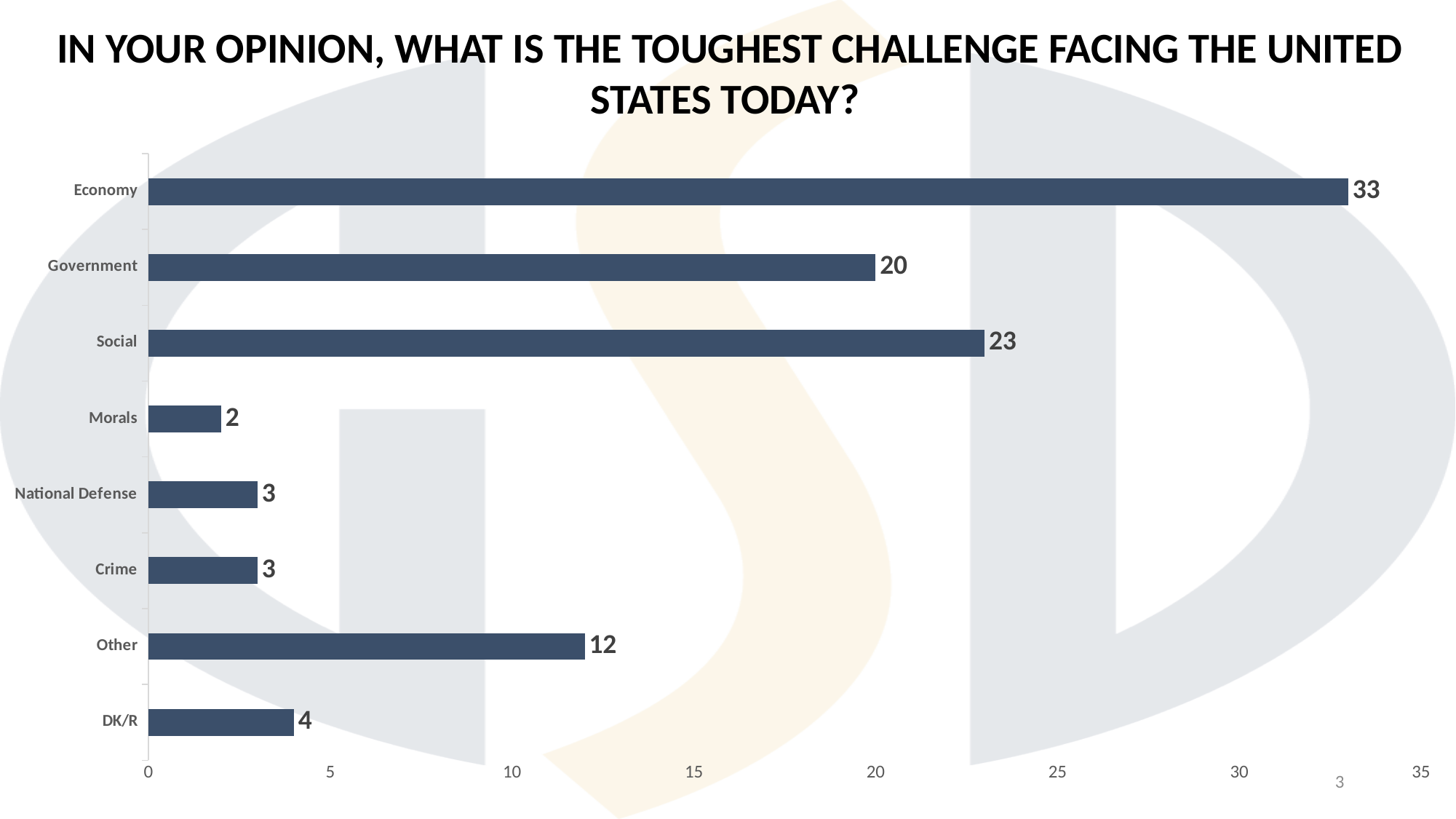
Is the value for Other greater or less than 10? greater What is the value for Other? 12 How many categories are shown in the chart? 8 What is the value for Economy? 33 Which category has the lowest value? Morals Which category has the highest value? Economy What is the difference between the values for Economy and Government? 13 What kind of chart is shown on the slide? Bar chart What is the value for Social? 23 What is the difference between the values for Social and Other? 11 What is the value for DK/R? 4 Which is larger, the value for Government or the value for Social? Social